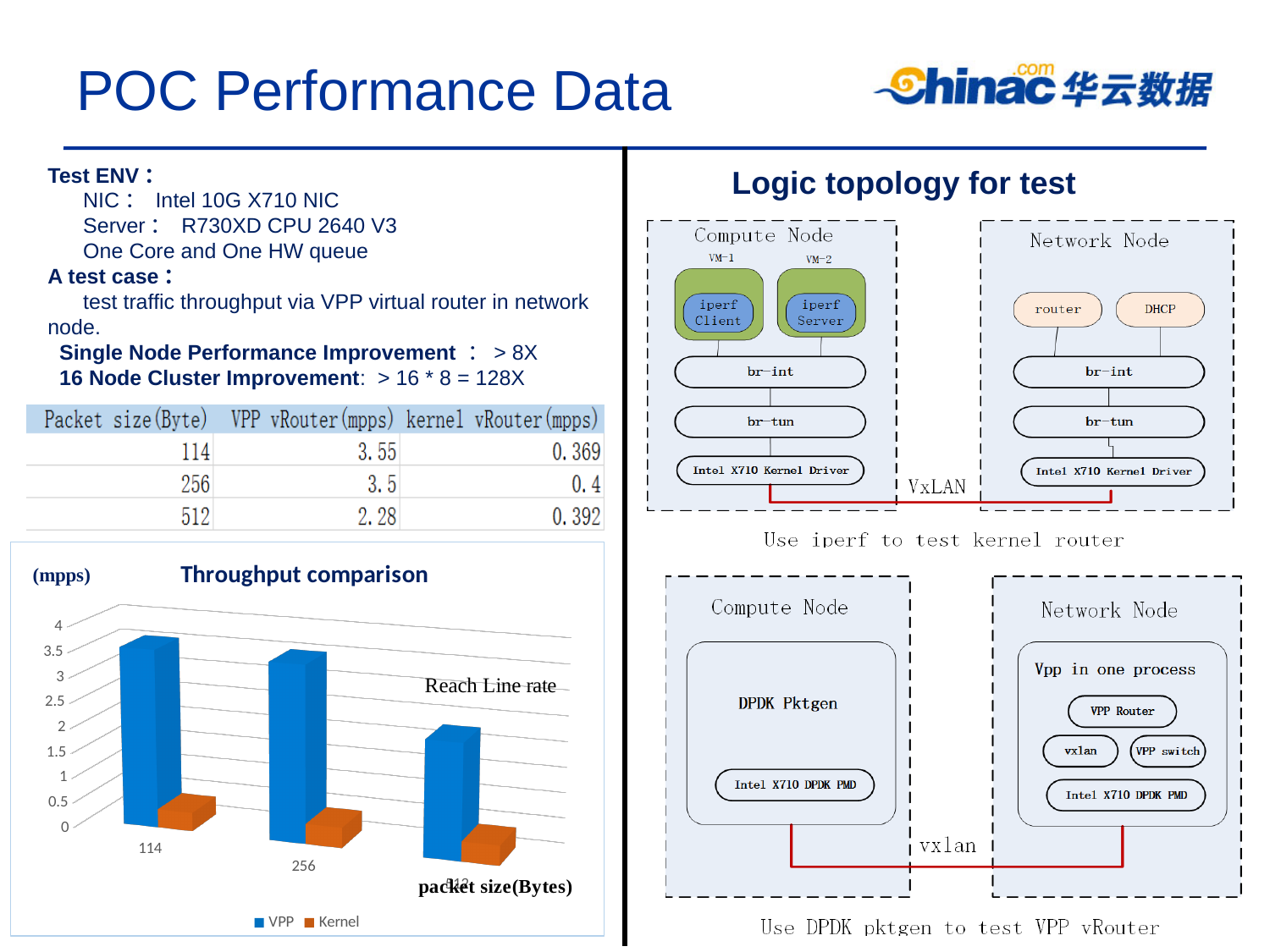
In the "Throughput comparison" chart, do the VPP values rise or fall as packet size increases along the x axis? fall In the "Throughput comparison" chart, which packet size has the highest VPP throughput? 114 What are the two legend entries of the "Throughput comparison" chart? VPP and Kernel In the "Throughput comparison" chart, is the VPP value for packet size 114 greater or less than 3? greater In the "Throughput comparison" chart, is the Kernel value for packet size 114 greater or less than 1? less How many series does the legend of the "Throughput comparison" chart list? 2 How many packet size categories are plotted in the "Throughput comparison" chart? 3 What kind of chart is the "Throughput comparison" chart? bar chart In the "Throughput comparison" chart, which series has the larger value at packet size 256, VPP or Kernel? VPP In the "Throughput comparison" chart, is the VPP value for the rightmost packet size greater or less than 2.5? less In the "Throughput comparison" chart, which packet size has the lowest VPP throughput? 512